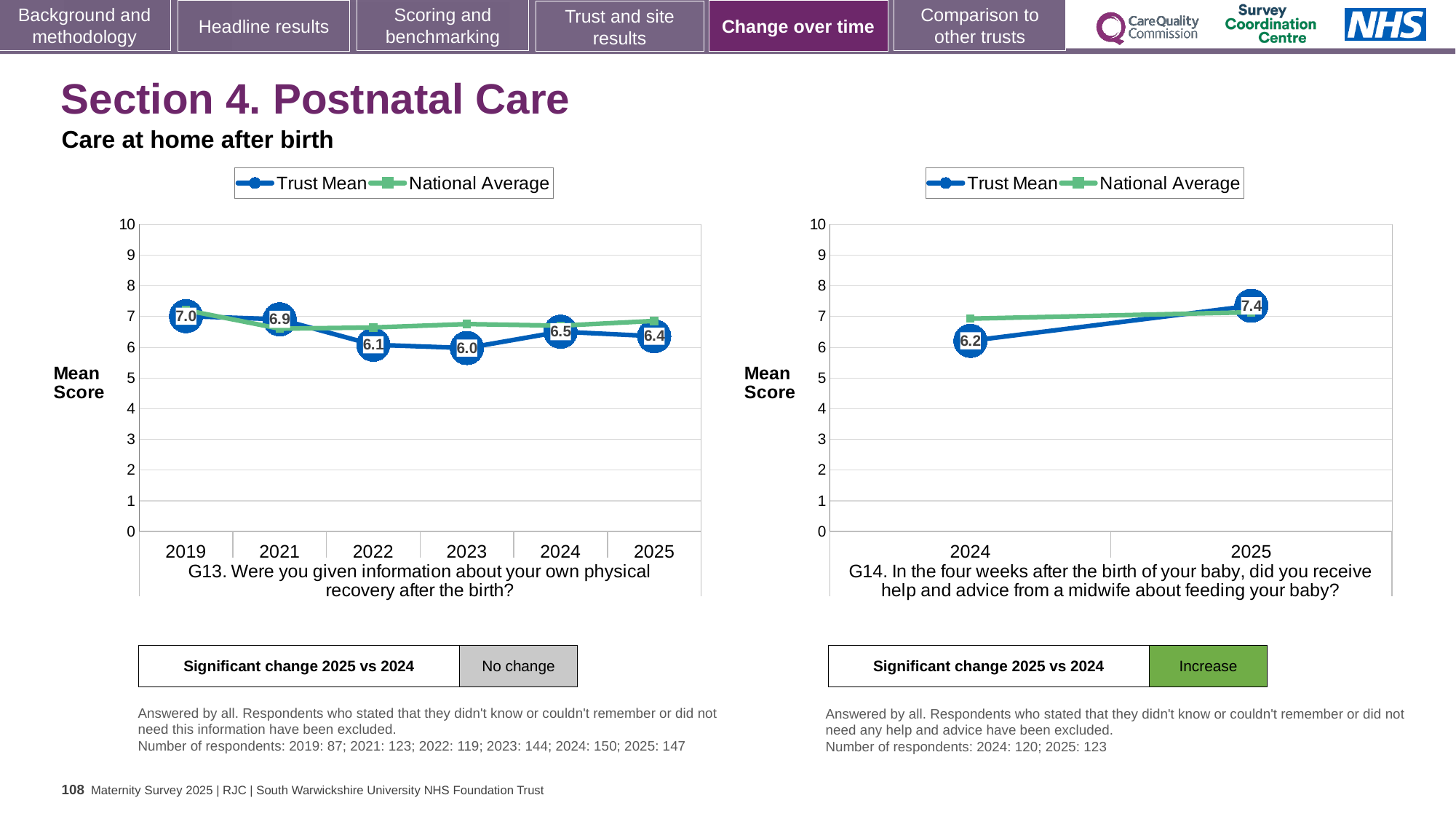
In the G13 chart (left), is the Trust Mean higher in 2024 or in 2022? 2024 In the G13 chart (left), which year has the highest Trust Mean? 2019 In the G14 chart (right), is the National Average for 2024 greater or less than 6? greater In the G14 chart (right), does the Trust Mean rise or fall from 2024 to 2025? Rise In the G13 chart (left), what is the Trust Mean for 2019? 7.0 In the G13 chart (left), which year has the lowest Trust Mean? 2023 How many years are plotted on the x axis of the G13 chart (left)? 6 In the G14 chart (right), what is the Trust Mean for 2025? 7.4 In the G13 chart (left), what is the Trust Mean for 2023? 6.0 How many series does the legend of the G14 chart (right) list? 2 In the G14 chart (right), what is the difference between the Trust Mean for 2025 and 2024? 1.2 What kind of chart is the G14 chart (right)? Line chart